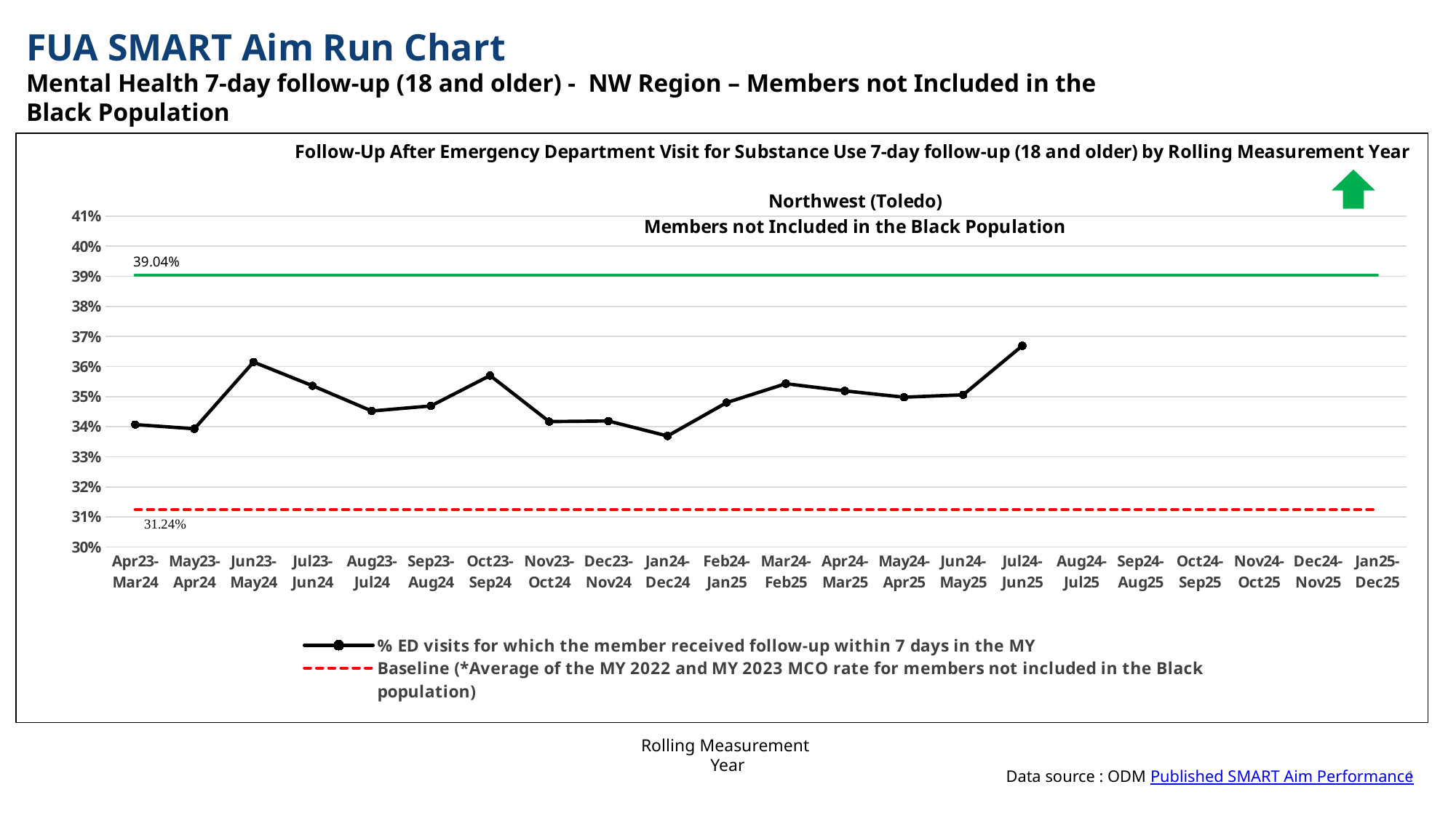
What value is printed for the green goal line at the top of the chart? 39.04% What kind of chart is shown on the slide? Line chart Which is larger, the value for Jun23-May24 or the value for Jul23-Jun24? Jun23-May24 How many series does the legend list? 2 Is the value for Jan24-Dec24 greater or less than 34%? less Is the value for Jul24-Jun25 greater or less than 36%? greater What is the difference between the green goal line value and the red baseline value? 7.80 percentage points Do the plotted values rise or fall from Jan24-Dec24 to Jul24-Jun25? Rise Is the value for Aug23-Jul24 greater or less than 35%? less What value is printed for the red dashed baseline line? 31.24% Which rolling measurement year has the highest plotted follow-up rate? Jul24-Jun25 How many data points are plotted on the black line? 16